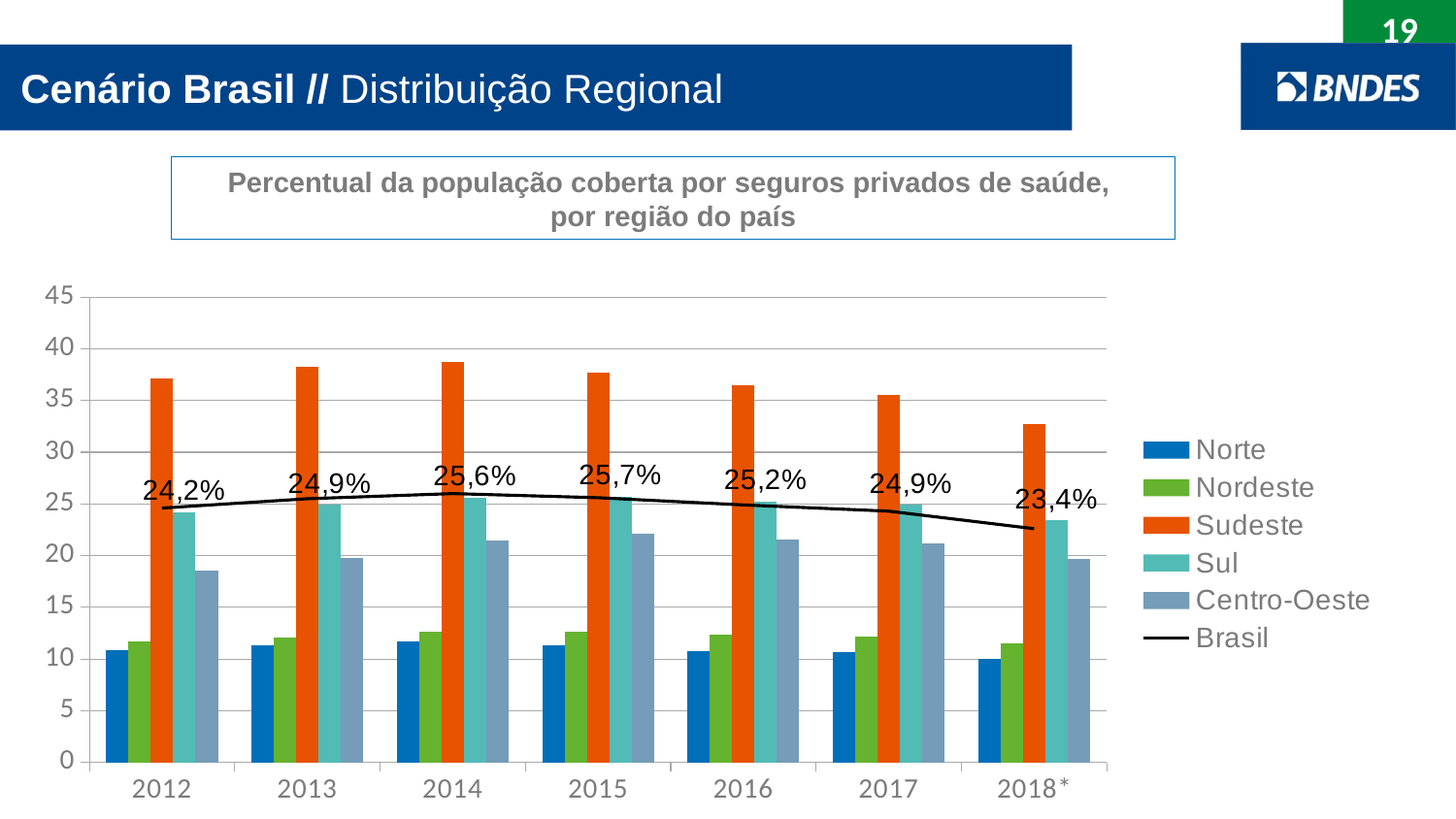
In which year does the Brasil line have its lowest value? 2018* What is the value of the Brasil line in 2014? 25,6% What is the value of the Brasil line in 2018*? 23,4% Does the Brasil line rise or fall from 2015 to 2018*? fall Is the value for Sudeste in 2014 greater or less than 35? greater How many series does the legend list? 6 What is the difference between the Brasil value in 2015 and in 2018*? 2,3 percentage points Is the value for Norte in 2018* greater or less than 15? less Which region has the highest bar in every year? Sudeste How many years are shown on the x axis? 7